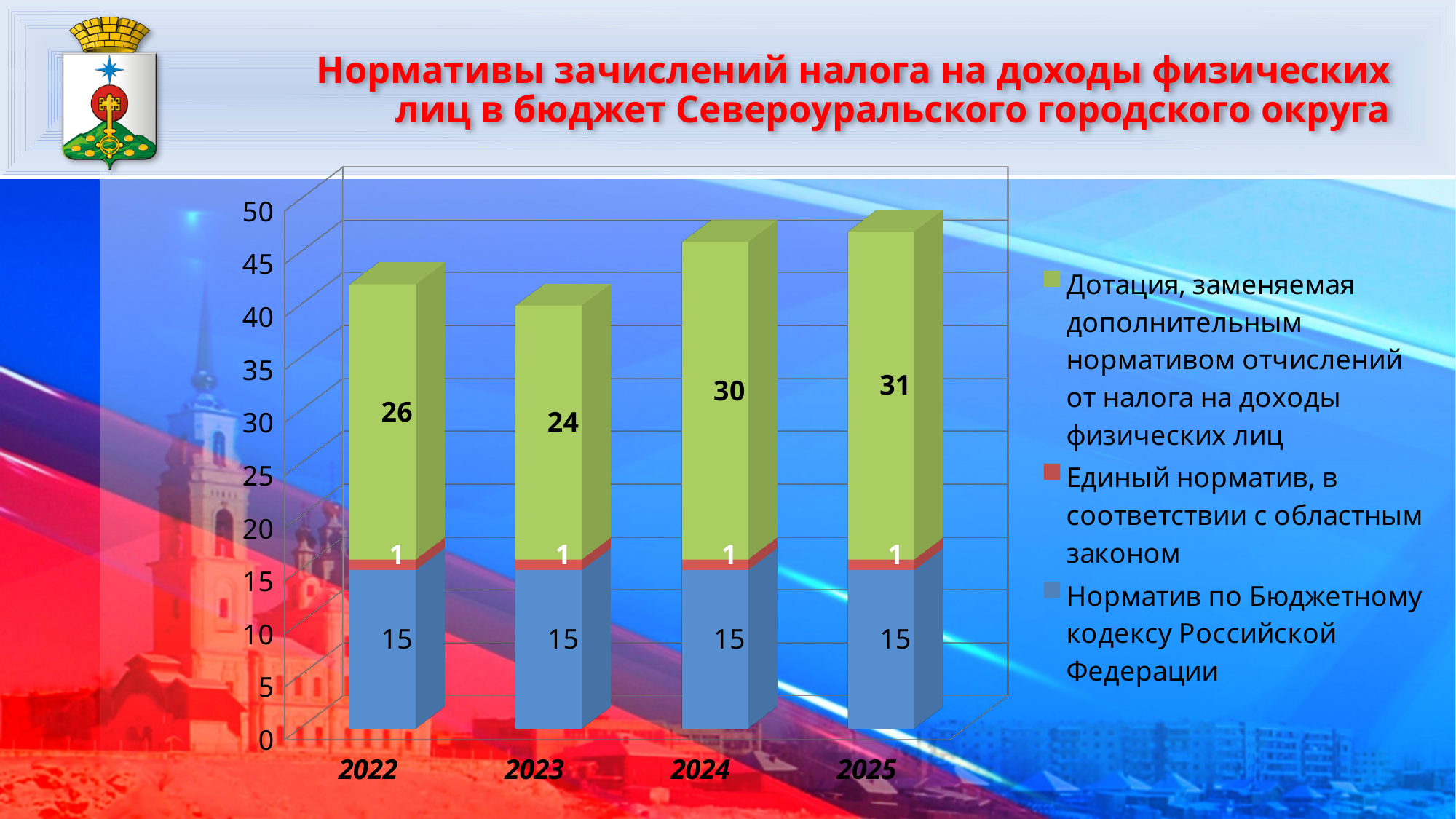
What is the total of the stacked bar for 2022? 42 What kind of chart is shown on the slide? Stacked bar chart What is the value of the 'Норматив по Бюджетному кодексу Российской Федерации' segment for 2022? 15 In which year is the 'Дотация, заменяемая дополнительным нормативом отчислений' segment the lowest? 2023 What is the value of the 'Единый норматив, в соответствии с областным законом' segment for 2025? 1 What is the difference between the 'Дотация' segment values for 2025 and 2023? 7 What is the total of the stacked bar for 2024? 46 How many series does the legend list? 3 How many years are shown on the x axis? 4 Which is larger: the 'Дотация' segment for 2022 or for 2024? 2024 What is the value of the 'Дотация, заменяемая дополнительным нормативом отчислений от налога на доходы физических лиц' segment for 2024? 30 In which year is the 'Дотация, заменяемая дополнительным нормативом отчислений' segment the highest? 2025